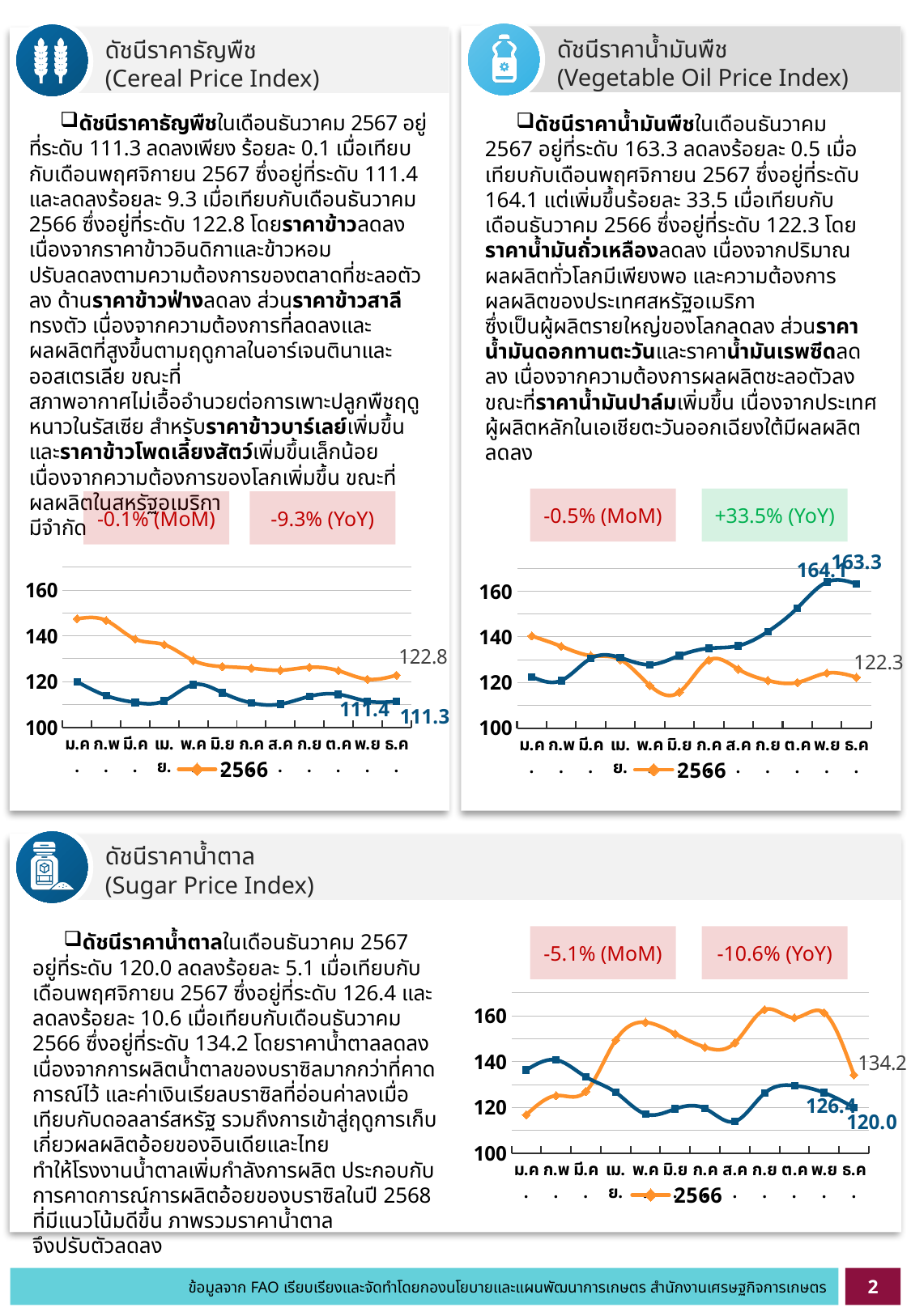
How many months are shown on the x axis of the Sugar Price Index chart? 12 In the Cereal Price Index chart, which line has the higher value in ธ.ค. (December), the 2566 (orange) line or the dark blue line? the 2566 (orange) line In the Vegetable Oil Price Index chart, what is the value of the dark blue line in พ.ย. (November)? 164.1 In the Sugar Price Index chart, what is the value of the dark blue line in ธ.ค. (December)? 120.0 In the Vegetable Oil Price Index chart, what is the difference between the dark blue line and the 2566 (orange) line in ธ.ค. (December)? 41.0 In the Sugar Price Index chart, what is the difference between the 2566 (orange) line and the dark blue line in ธ.ค. (December)? 14.2 In the Cereal Price Index chart, does the 2566 (orange) line generally rise or fall from ม.ค. to ธ.ค.? fall In the Cereal Price Index chart, what is the value of the dark blue line in ธ.ค. (December)? 111.3 In the Cereal Price Index chart, is the value of the 2566 (orange) line in ม.ค. (January) greater or less than 140? greater What kind of chart is the Cereal Price Index chart? line chart In the Vegetable Oil Price Index chart, what is the value of the 2566 (orange) line in ธ.ค. (December)? 122.3 In the Cereal Price Index chart, what is the value of the 2566 (orange) line in ธ.ค. (December)? 122.8